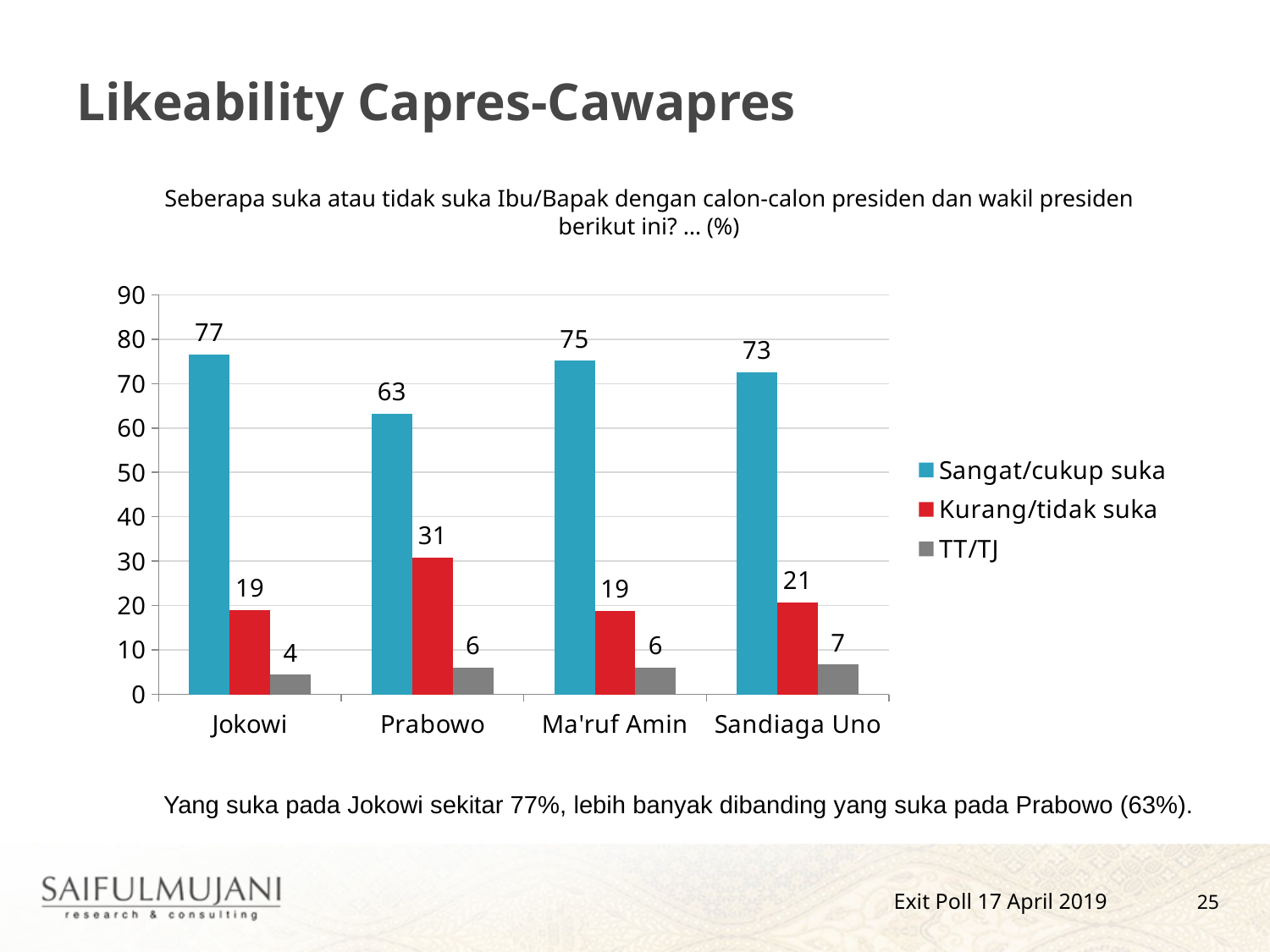
What is the value for Sangat/cukup suka for Jokowi? 77 What is the value for Kurang/tidak suka for Prabowo? 31 What is the TT/TJ value for Sandiaga Uno? 7 Which is larger: the Kurang/tidak suka value for Prabowo or for Sandiaga Uno? Prabowo Which series is shown in red in the legend? Kurang/tidak suka Which candidate has the lowest Sangat/cukup suka value? Prabowo How many candidates are shown on the x axis? 4 Which candidate has the highest Sangat/cukup suka value? Jokowi What kind of chart is shown on the slide? bar chart How many series does the legend list? 3 What is the difference between the Sangat/cukup suka values for Jokowi and Prabowo? 14 Is the Sangat/cukup suka value for Ma'ruf Amin greater or less than 70? greater